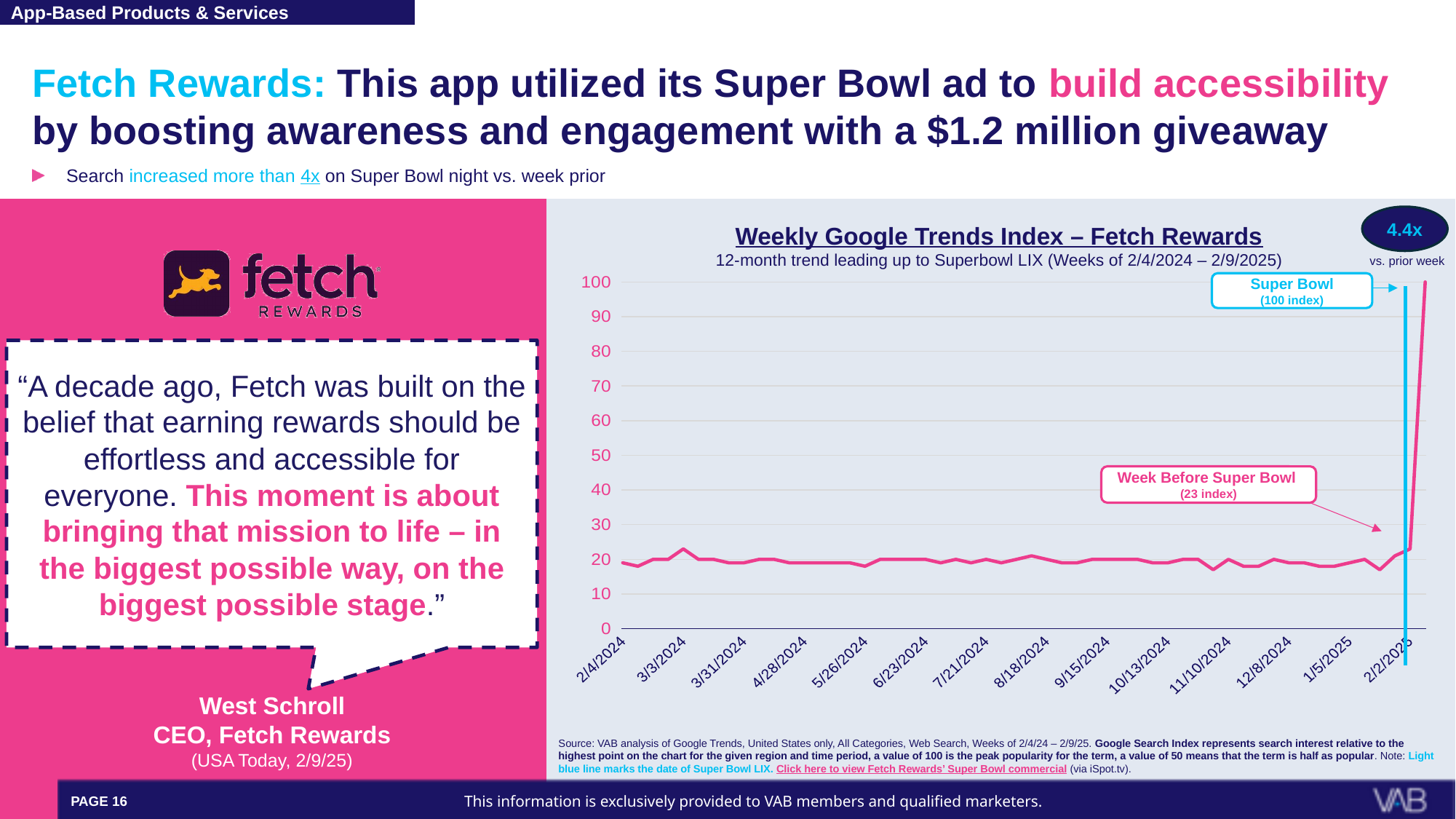
By how many index points does the Super Bowl week value exceed the week before the Super Bowl? 77 What does the light blue vertical line on the chart mark? The date of Super Bowl LIX Which week has the highest Google Trends index on the chart? Super Bowl week What is the Google Trends index value for the week before the Super Bowl? 23 Is the index value for the week of 2/4/2024 greater or less than 30? less Is the index value for the week of 9/15/2024 greater or less than 50? less What is the title of the chart? Weekly Google Trends Index – Fetch Rewards Does the index rise or fall between the week before the Super Bowl and the Super Bowl week? rise What is the Google Trends index value for the Super Bowl week? 100 By what multiple did the index increase in the Super Bowl week versus the prior week, according to the callout? 4.4x What kind of chart is shown on the slide? Line chart How many date labels are shown on the x axis of the chart? 14